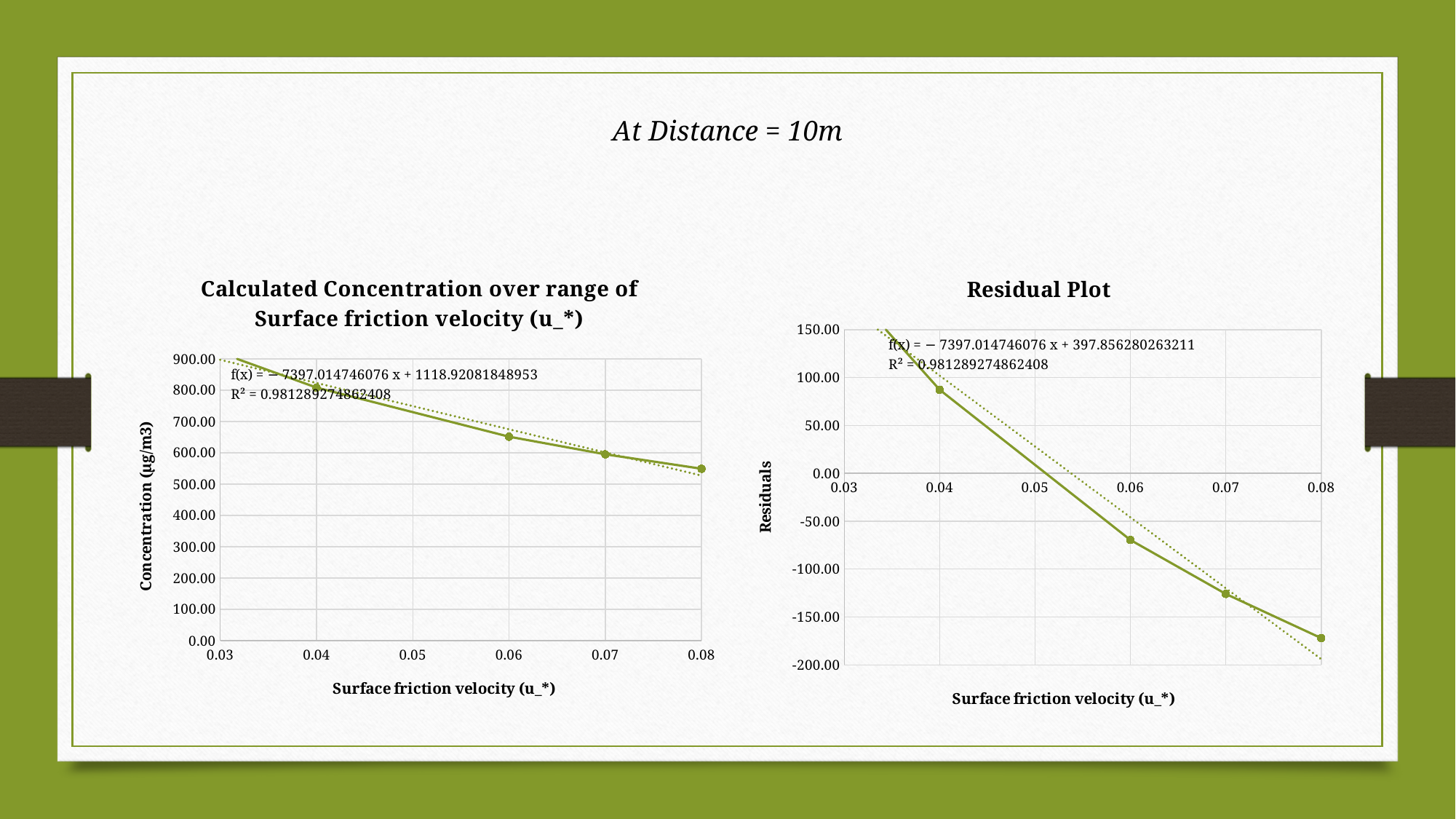
In the 'Residual Plot' chart, is the residual at 0.04 greater or less than 50.00? greater What is the R² value shown on the 'Residual Plot' chart? 0.981289274862408 In the 'Calculated Concentration over range of Surface friction velocity (u_*)' chart, is the concentration at 0.08 greater or less than 600.00? less What type of chart is the 'Calculated Concentration over range of Surface friction velocity (u_*)' chart? line chart How many data points are plotted in the 'Residual Plot' chart? 5 In the 'Calculated Concentration over range of Surface friction velocity (u_*)' chart, do the concentration values rise or fall as surface friction velocity increases? fall In the 'Calculated Concentration over range of Surface friction velocity (u_*)' chart, at which surface friction velocity is the concentration highest? 0.03 In the 'Residual Plot' chart, is the residual at 0.08 greater or less than -150.00? less How many data points are plotted in the 'Calculated Concentration over range of Surface friction velocity (u_*)' chart? 5 What type of chart is the 'Residual Plot' chart? line chart In the 'Residual Plot' chart, do the residuals rise or fall as surface friction velocity increases? fall